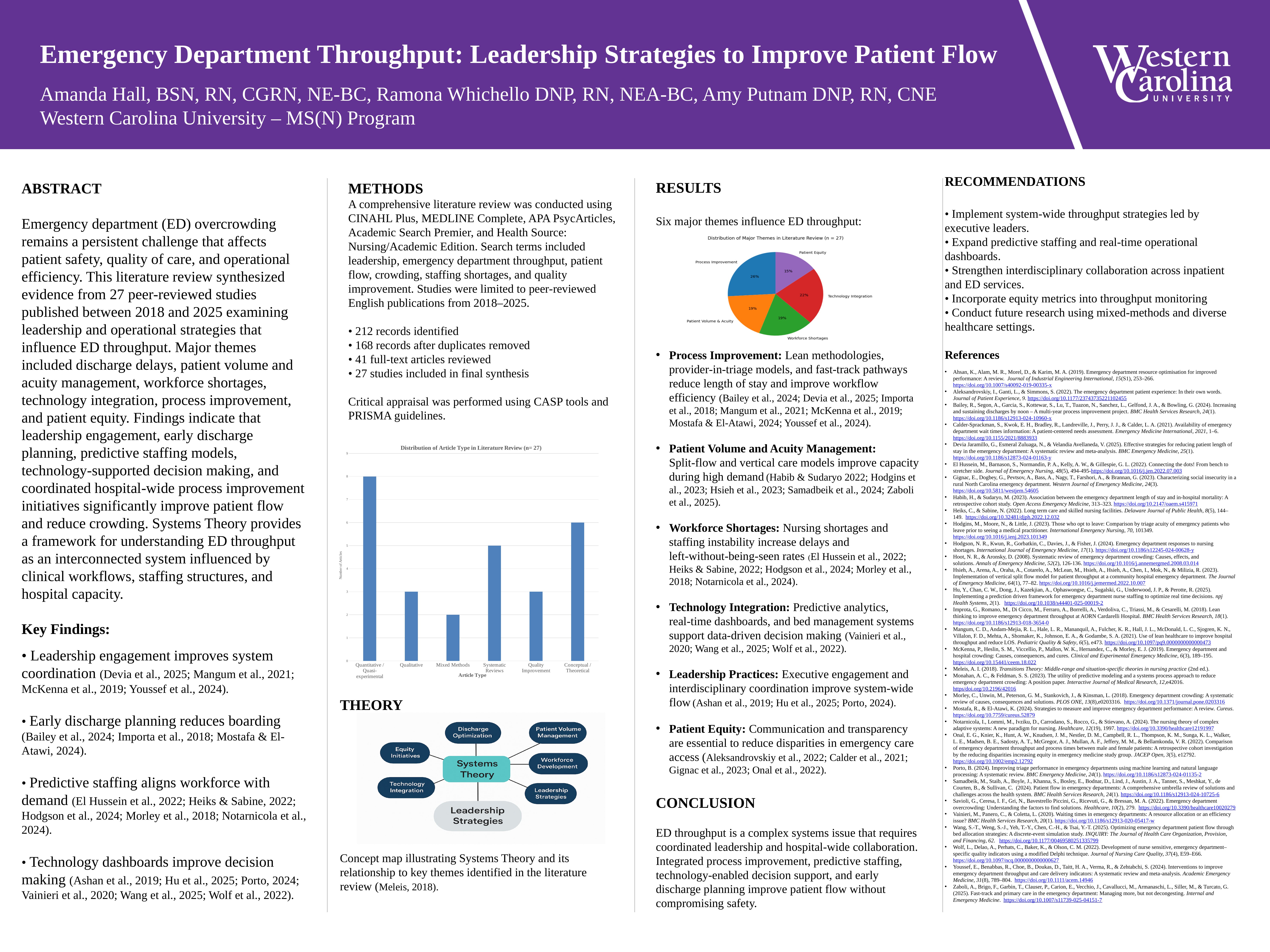
In the bar chart 'Distribution of Article Type in Literature Review', which article type has the most articles? Quantitative / Quasi-experimental In the pie chart 'Distribution of Major Themes in Literature Review', which theme has the smallest slice? Patient Equity In the pie chart 'Distribution of Major Themes in Literature Review', which theme has the largest slice? Process Improvement In the bar chart 'Distribution of Article Type in Literature Review', which has more articles: Conceptual / Theoretical or Systematic Reviews? Conceptual / Theoretical In the pie chart 'Distribution of Major Themes in Literature Review', what percentage is labelled for Process Improvement? 26% In the pie chart 'Distribution of Major Themes in Literature Review', what percentage is labelled for Technology Integration? 22% In the pie chart 'Distribution of Major Themes in Literature Review', what is the difference in percentage points between Process Improvement and Patient Equity? 11 In the bar chart 'Distribution of Article Type in Literature Review', how many article types are shown on the x axis? 6 In the bar chart 'Distribution of Article Type in Literature Review', which article type has the fewest articles? Mixed Methods What kind of chart is 'Distribution of Article Type in Literature Review'? Bar chart In the bar chart 'Distribution of Article Type in Literature Review', how many articles are Systematic Reviews? 5 In the bar chart 'Distribution of Article Type in Literature Review', how many articles are Quantitative / Quasi-experimental? 8